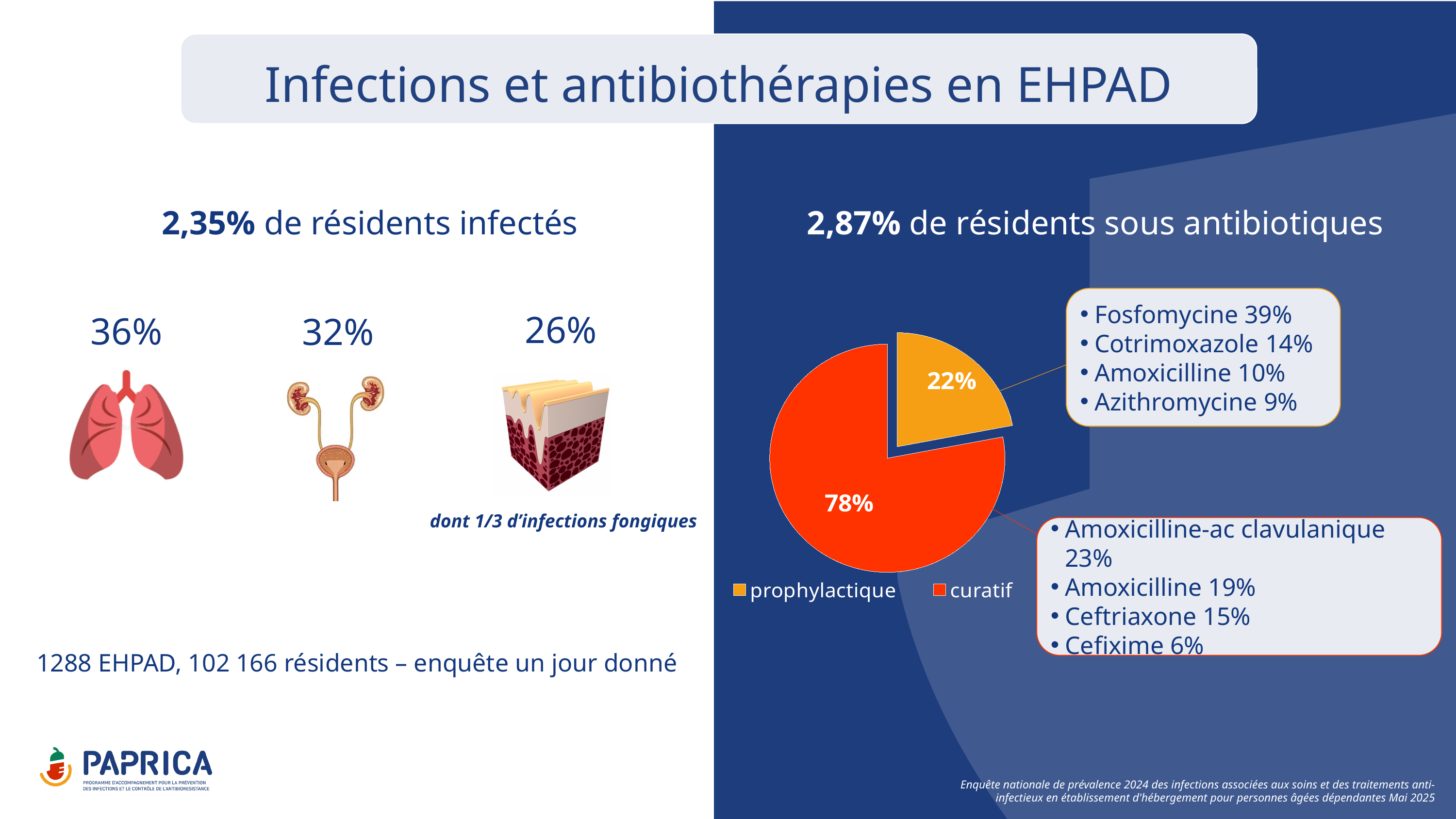
What share of the pie chart is labelled curatif? 78% What colour is the prophylactique slice of the pie chart? orange What is the difference in percentage points between the curatif and prophylactique slices? 56 Which slice of the pie chart is the largest? curatif Which is larger in the pie chart, prophylactique or curatif? curatif Which slice of the pie chart is the smallest? prophylactique How many slices does the pie chart have? 2 What share of the pie chart is labelled prophylactique? 22% How many entries does the pie chart legend list? 2 What colour is the curatif slice of the pie chart? red What kind of chart is shown on the slide? pie chart